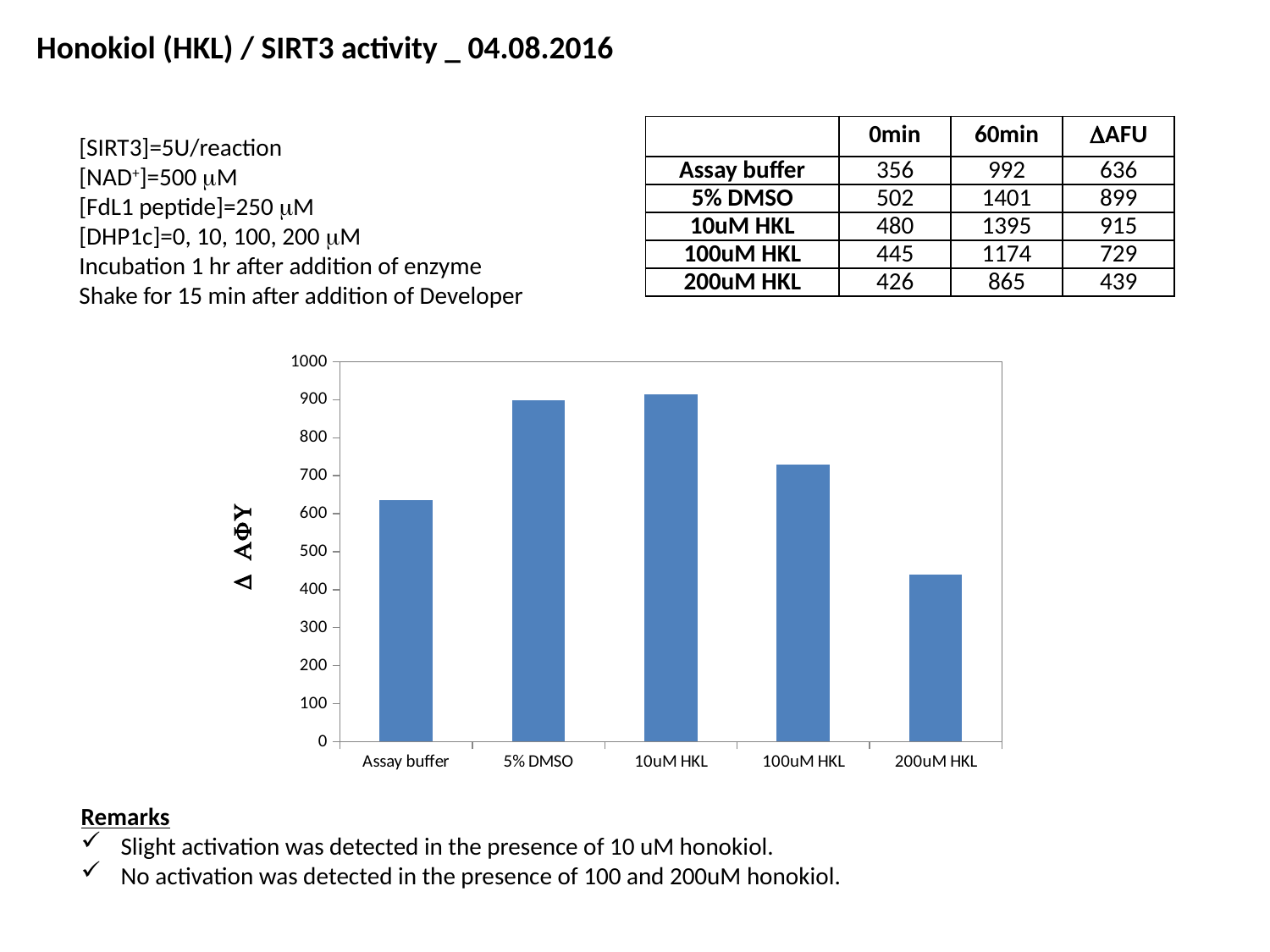
Is the value for 5% DMSO greater or less than 800? greater Which is larger, the bar for Assay buffer or the bar for 5% DMSO? 5% DMSO Is the value for 200uM HKL greater or less than 500? less Is the value for 100uM HKL greater or less than 700? greater What kind of chart is shown on the slide? bar chart According to the table, what is the ΔAFU value for 10uM HKL? 915 Which category has the lowest bar in the chart? 200uM HKL What is the maximum value shown on the y axis of the chart? 1000 How many categories are plotted on the x axis of the chart? 5 Which is larger, the bar for 100uM HKL or the bar for 200uM HKL? 100uM HKL Which category has the highest bar in the chart? 10uM HKL